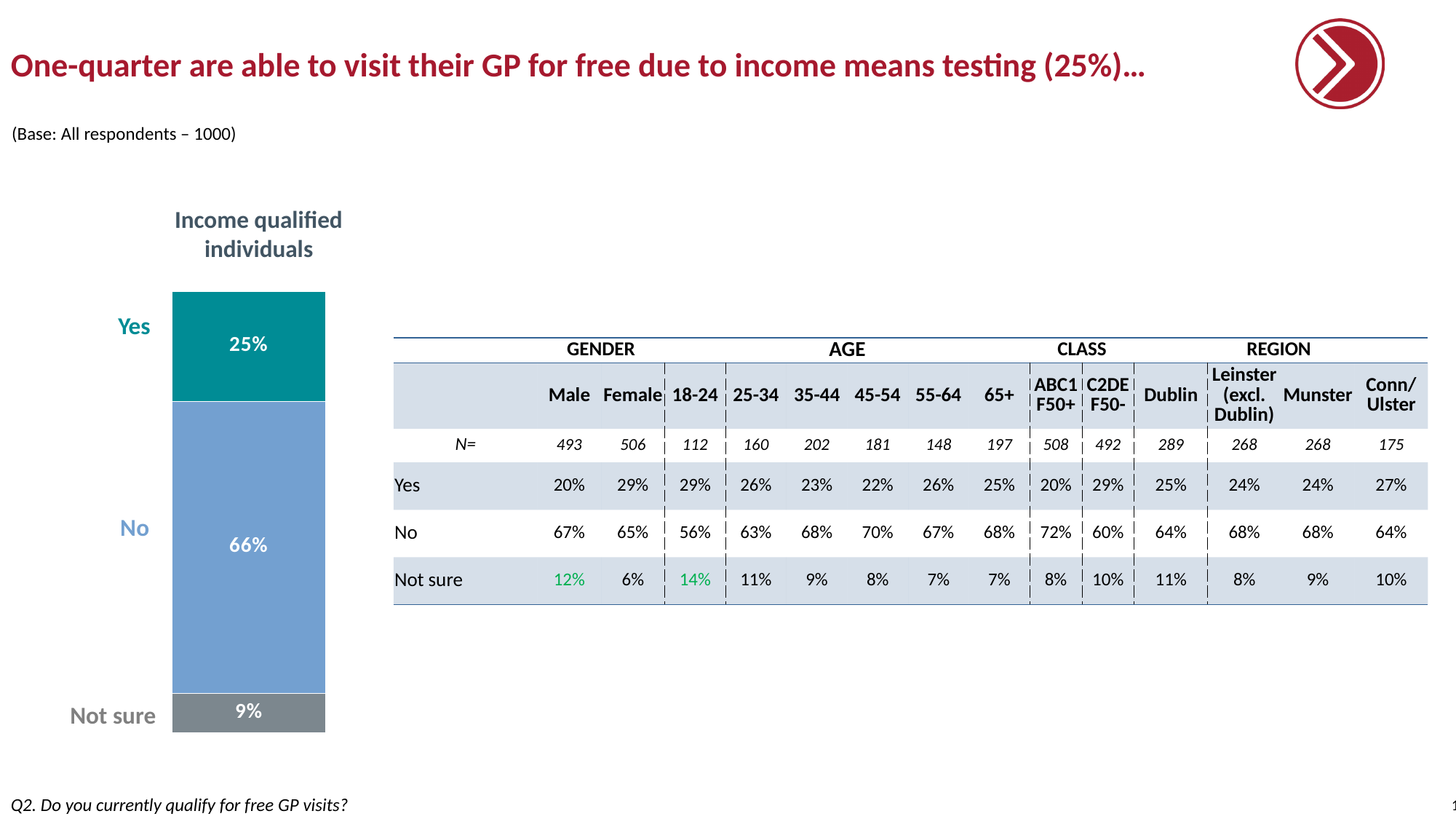
Which response has the largest share in the 'Income qualified individuals' chart? No How many response categories are shown in the stacked bar chart? 3 What type of chart is used to show the 'Income qualified individuals' data? Stacked bar chart What percentage of income qualified individuals answered 'Not sure'? 9% What is the title of the chart on the left of the slide? Income qualified individuals Which response has the smallest share in the 'Income qualified individuals' chart? Not sure What percentage of income qualified individuals answered 'No'? 66% What is the total of the three segments in the stacked bar? 100% Which is larger in the chart, the 'Yes' share or the 'Not sure' share? Yes What is the difference between the 'No' and 'Yes' percentages in the chart? 41% What colour is the 'Yes' segment of the stacked bar? Teal What percentage of income qualified individuals answered 'Yes'? 25%